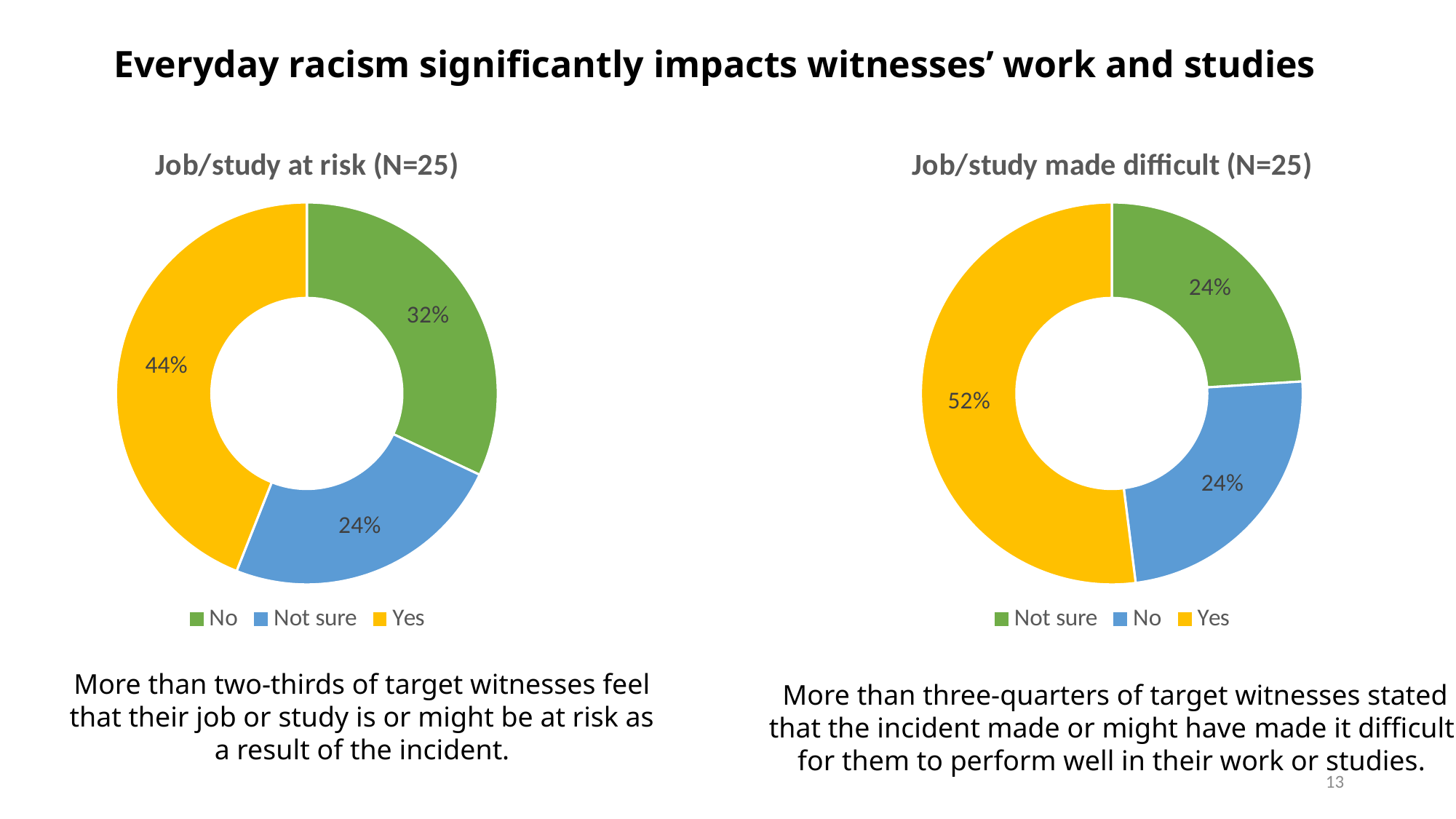
In the 'Job/study at risk (N=25)' chart, what percentage answered Yes? 44% In the 'Job/study made difficult (N=25)' chart, what percentage answered No? 24% In the 'Job/study made difficult (N=25)' chart, which response has the largest share? Yes In the 'Job/study at risk (N=25)' chart, what percentage answered No? 32% Is the Yes share larger in the 'Job/study at risk' chart or the 'Job/study made difficult' chart? Job/study made difficult In the 'Job/study at risk (N=25)' chart, which response has the smallest share? Not sure In the 'Job/study made difficult (N=25)' chart, what percentage answered Yes? 52% In the 'Job/study at risk (N=25)' chart, what is the difference between the Yes and No percentages? 12% How many categories does the legend of the 'Job/study made difficult (N=25)' chart list? 3 What kind of chart is the 'Job/study at risk (N=25)' chart? Doughnut chart In the 'Job/study at risk (N=25)' chart, which response has the largest share? Yes In the 'Job/study at risk (N=25)' chart, what percentage answered Not sure? 24%